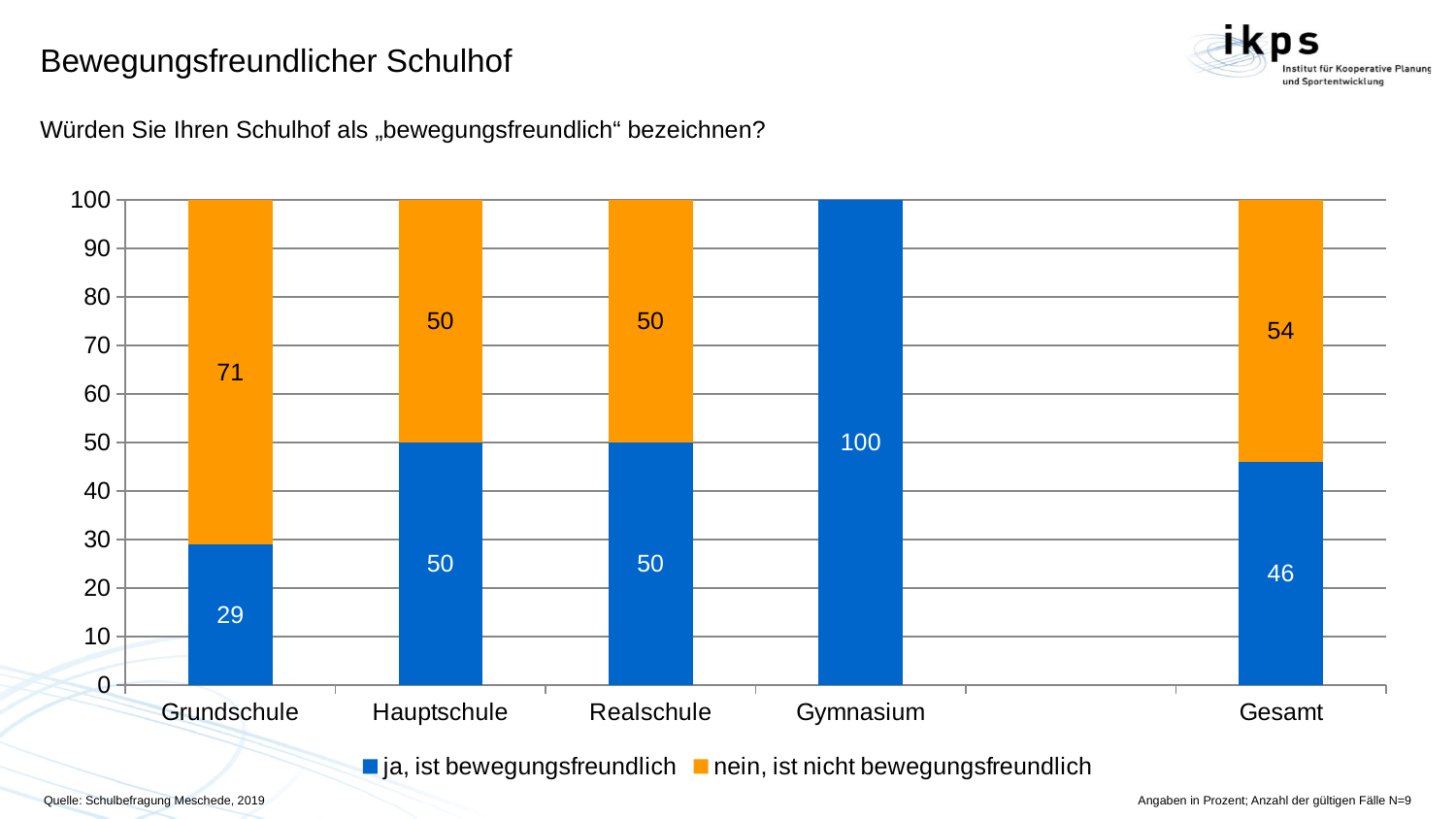
What kind of chart is shown on the slide? Stacked bar chart Which school type has the lowest value for "ja, ist bewegungsfreundlich"? Grundschule What is the total of the stacked bar for Gesamt? 100 What is the value for "ja, ist bewegungsfreundlich" for Gesamt? 46 What is the value for "ja, ist bewegungsfreundlich" for Grundschule? 29 What is the value for "nein, ist nicht bewegungsfreundlich" for Grundschule? 71 How many series does the legend list? 2 What is the value for "ja, ist bewegungsfreundlich" for Gymnasium? 100 Which school type has the highest value for "ja, ist bewegungsfreundlich"? Gymnasium What is the difference between the "nein, ist nicht bewegungsfreundlich" values for Grundschule and Gesamt? 17 What is the value for "nein, ist nicht bewegungsfreundlich" for Gesamt? 54 Which is larger: the "ja, ist bewegungsfreundlich" value for Hauptschule or for Gesamt? Hauptschule